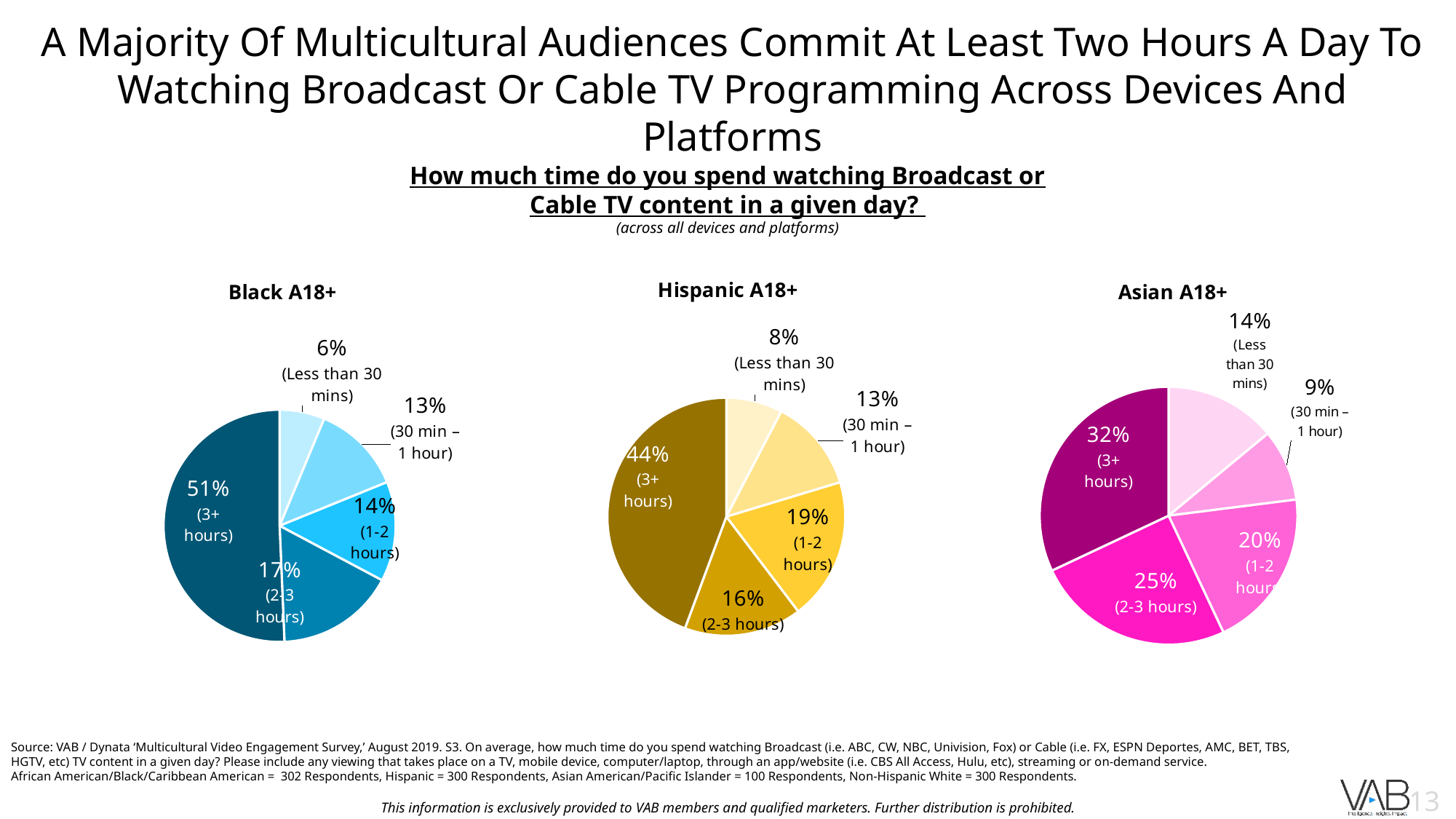
How many pie charts are shown on the slide? 3 In the Hispanic A18+ pie chart, what share of respondents watch 1-2 hours? 19% In the Asian A18+ pie chart, which category has the largest share? 3+ hours How many slices does the Hispanic A18+ pie chart have? 5 In the Black A18+ pie chart, what is the combined share of respondents watching 2-3 hours and 3+ hours? 68% What type of chart is used for the Black A18+ data? Pie chart In the Hispanic A18+ pie chart, what is the difference between the 3+ hours share and the 2-3 hours share? 28 percentage points Which of the three pie charts shows the highest share for 3+ hours? Black A18+ In the Asian A18+ pie chart, what share of respondents watch less than 30 mins? 14% In the Black A18+ pie chart, which category has the smallest share? Less than 30 mins In the Asian A18+ pie chart, which is larger: the 2-3 hours share or the 1-2 hours share? 2-3 hours In the Black A18+ pie chart, what share of respondents watch 3+ hours? 51%